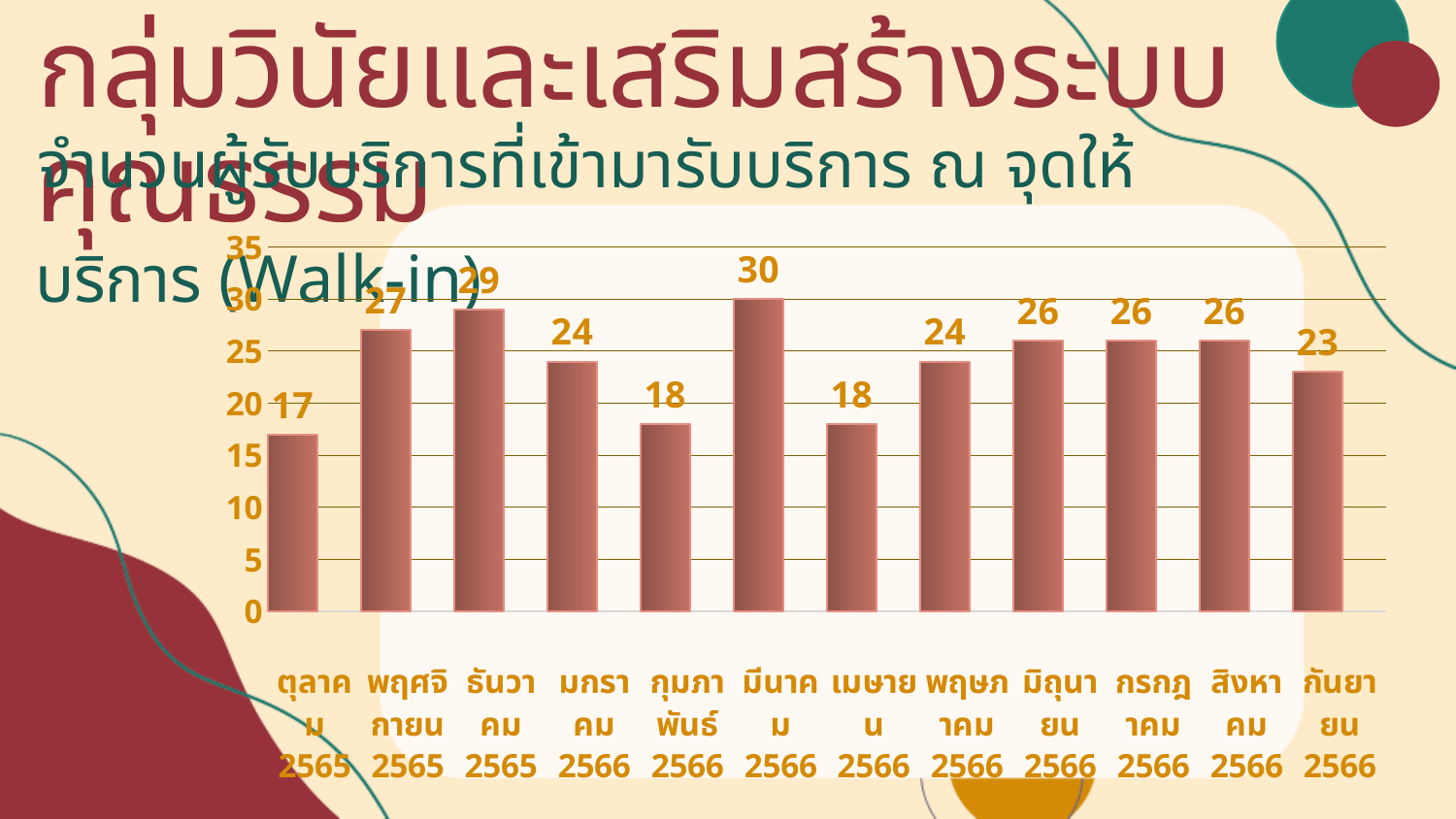
Do the values rise or fall from ตุลาคม 2565 to ธันวาคม 2565? rise What is the difference between the values for ธันวาคม 2565 and มกราคม 2566? 5 Which is larger, the value for พฤศจิกายน 2565 or the value for พฤษภาคม 2566? พฤศจิกายน 2565 Which month has the lowest value? ตุลาคม 2565 What kind of chart is shown on the slide? bar chart What is the value for มีนาคม 2566? 30 Is the value for กุมภาพันธ์ 2566 greater or less than 20? less What is the difference between the values for มีนาคม 2566 and เมษายน 2566? 12 How many months are shown on the x axis? 12 What is the value for กันยายน 2566? 23 What is the value for ตุลาคม 2565? 17 Which month has the highest value? มีนาคม 2566